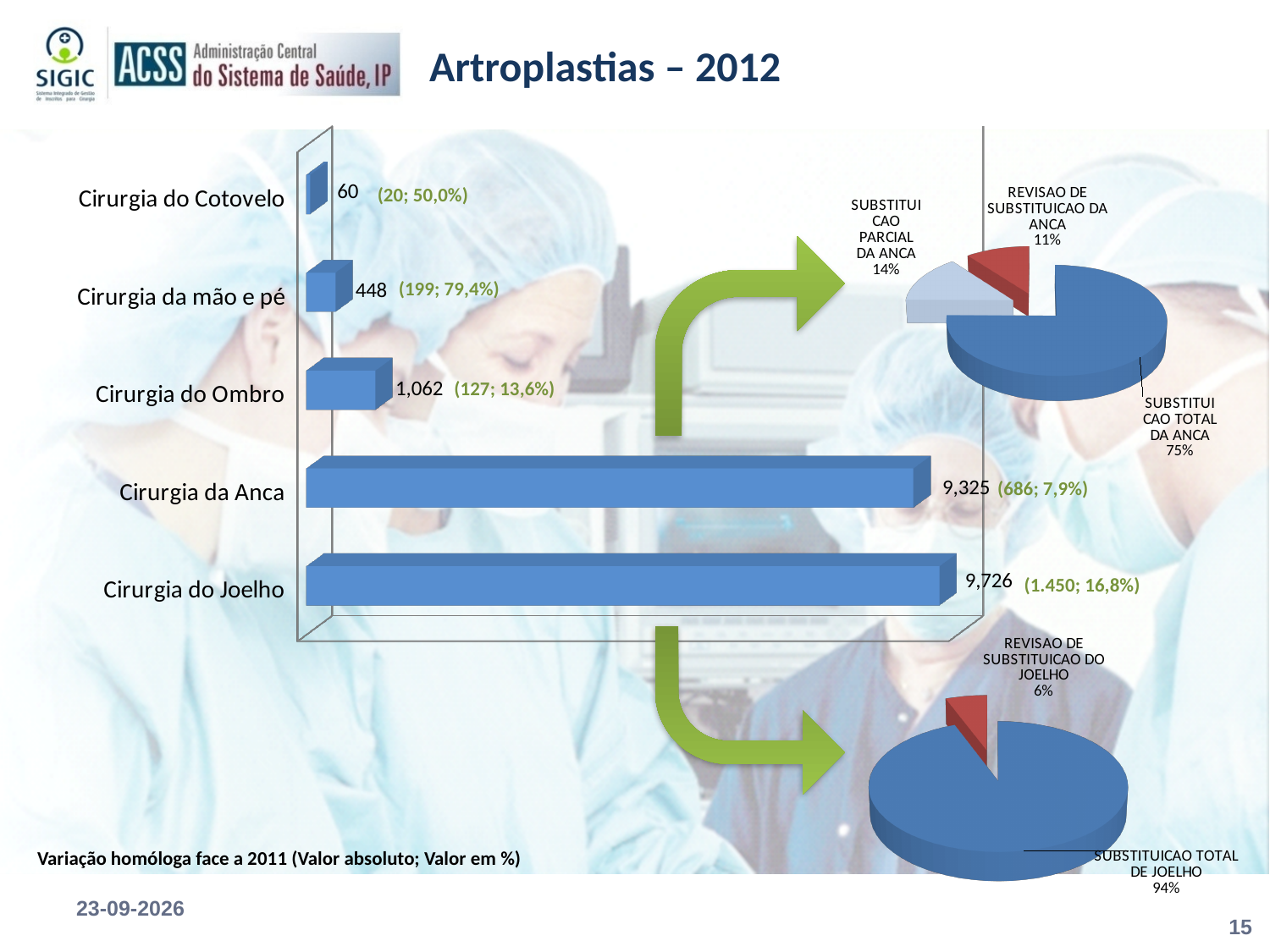
In the bar chart on the left, which is larger: the value for Cirurgia do Ombro or the value for Cirurgia da mão e pé? Cirurgia do Ombro In the upper pie chart (anca), what share does Revisao de Substituicao da Anca have? 11% In the lower pie chart (joelho), what share does Revisao de Substituicao do Joelho have? 6% In the bar chart on the left, which category has the lowest value? Cirurgia do Cotovelo In the upper pie chart (anca), what share does Substituicao Total da Anca have? 75% How many categories does the bar chart on the left show? 5 In the bar chart on the left, what is the difference between the values for Cirurgia do Joelho and Cirurgia da Anca? 401 In the bar chart on the left, which category has the highest value? Cirurgia do Joelho In the bar chart on the left, what is the value for Cirurgia do Joelho? 9,726 In the bar chart on the left, what is the value for Cirurgia da mão e pé? 448 What kind of chart is the chart on the left of the slide? Bar chart In the bar chart on the left, what is the value for Cirurgia do Ombro? 1,062